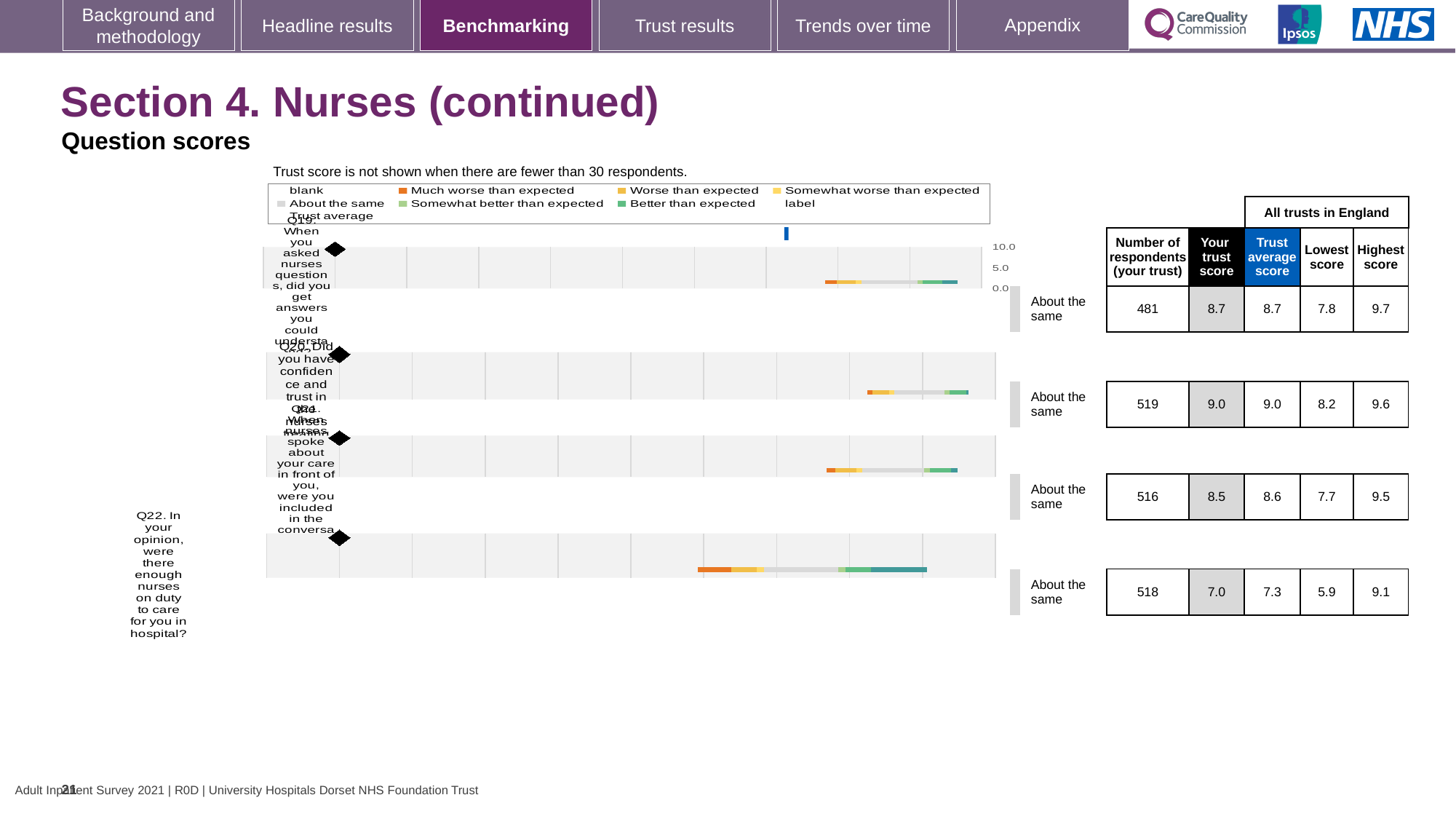
What is the lowest score across all trusts in England for Q22? 5.9 What is the 'Your trust score' value for Q22 (enough nurses on duty)? 7.0 What is the highest score across all trusts in England for Q19? 9.7 Which has the larger 'Your trust score', Q19 or Q21? Q19 What is the difference between the highest score and the lowest score for Q20? 1.4 What kind of chart is used to show the question scores? Bar chart Which question has the highest 'Your trust score'? Q20 What benchmark category label is shown next to each of the four questions? About the same Which question has the lowest 'Your trust score'? Q22 What is the difference between the trust average score and your trust score for Q22? 0.3 How many respondents (your trust) are shown for Q20 (confidence and trust in nurses)? 519 How many questions are plotted in the chart? 4